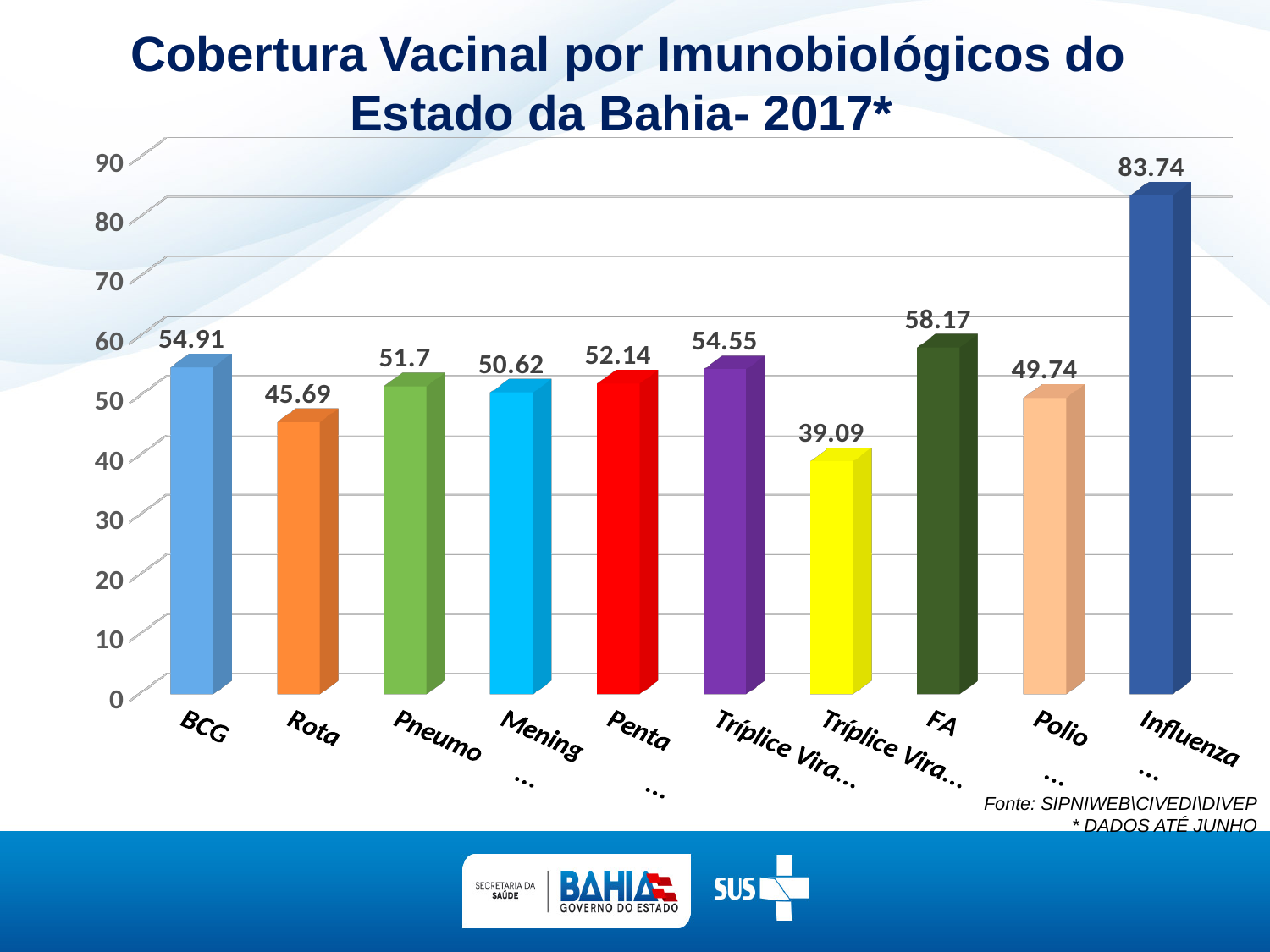
What is the difference between the values for BCG and Rota? 9.22 What is the value for BCG? 54.91 What is the lowest value shown on the chart? 39.09 What kind of chart is shown on the slide? bar chart What is the value for Penta? 52.14 Which is larger, the value for Penta or the value for Mening? Penta Which category has the highest value? Influenza What is the value for Rota? 45.69 How many bars are shown on the chart? 10 What is the difference between the values for Influenza and FA? 25.57 Is the value for Rota greater or less than 50? less What is the value for FA? 58.17